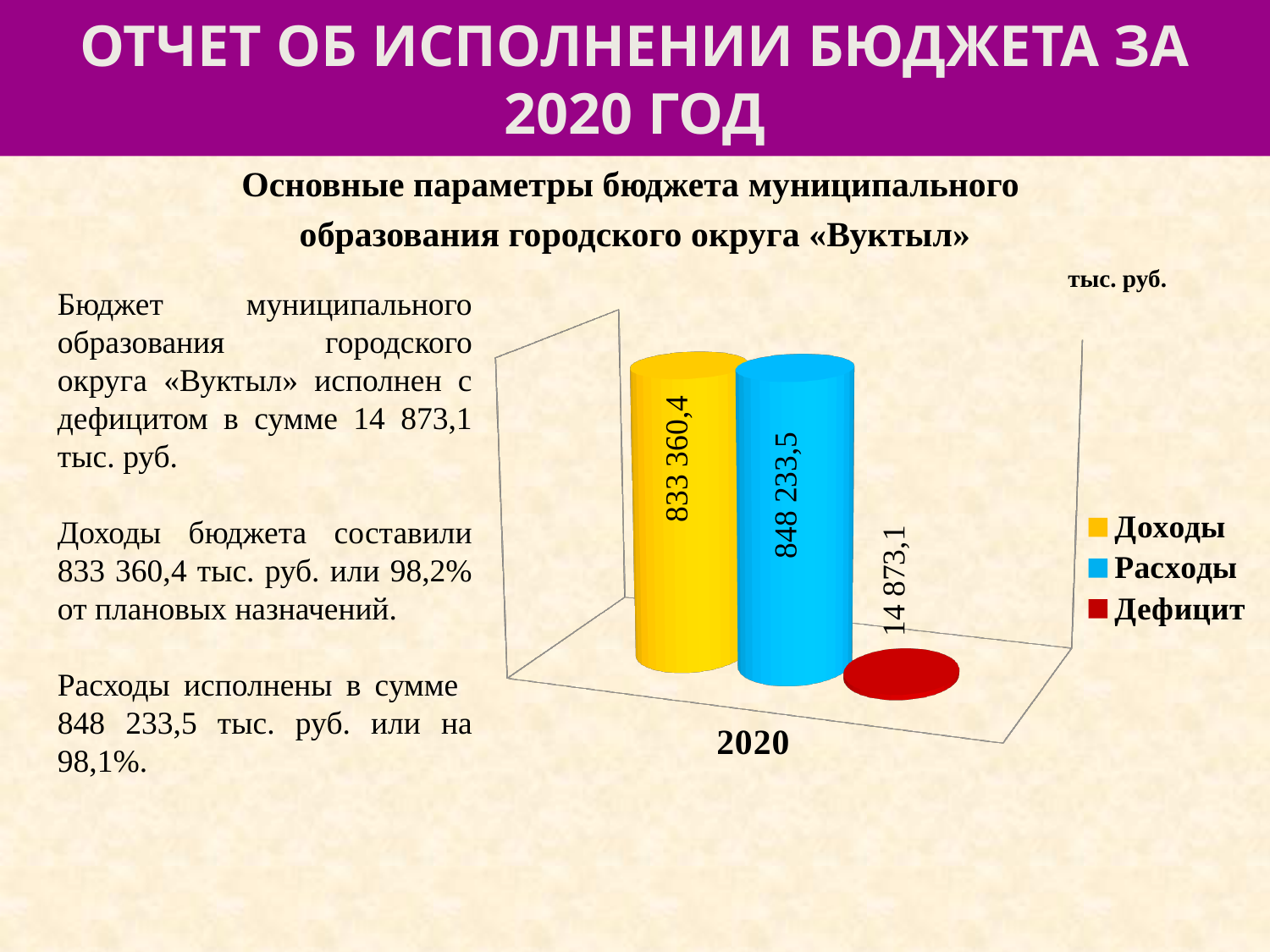
What kind of chart is shown on the slide? bar chart What is the value for Доходы in 2020? 833 360,4 What colour represents Дефицит in the chart? red How many categories are shown on the x axis? 1 What is the value for Дефицит in 2020? 14 873,1 Which series has the highest value in 2020? Расходы Which is larger in 2020, Доходы or Расходы? Расходы What is the value for Расходы in 2020? 848 233,5 Which series has the lowest value in 2020? Дефицит What unit is indicated above the chart? тыс. руб. What is the difference between Расходы and Доходы in 2020? 14 873,1 How many series does the legend list? 3